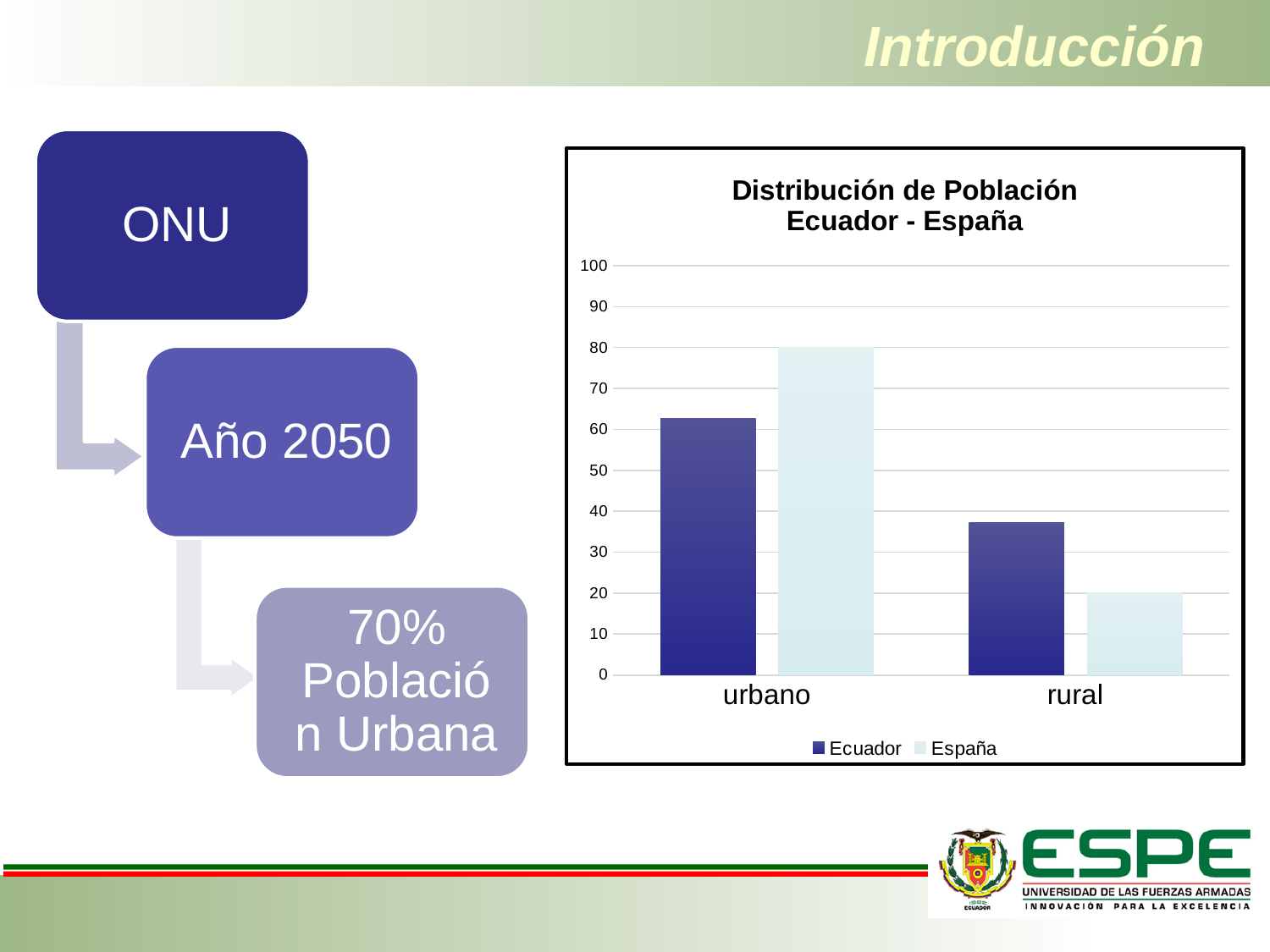
Which category has the highest value for the España series? urbano Is the value for Ecuador in the urbano category greater or less than 60? greater What is the difference between the España values for urbano and rural? 60 Which series has the higher value in the rural category, Ecuador or España? Ecuador How many categories are shown on the x axis of the chart? 2 What is the value for España in the rural category? 20 How many series does the chart legend list? 2 What kind of chart is shown on the slide? bar chart Is the value for Ecuador in the rural category greater or less than 40? less What is the value for España in the urbano category? 80 What is the title of the chart? Distribución de Población Ecuador - España Which series has the higher value in the urbano category, Ecuador or España? España